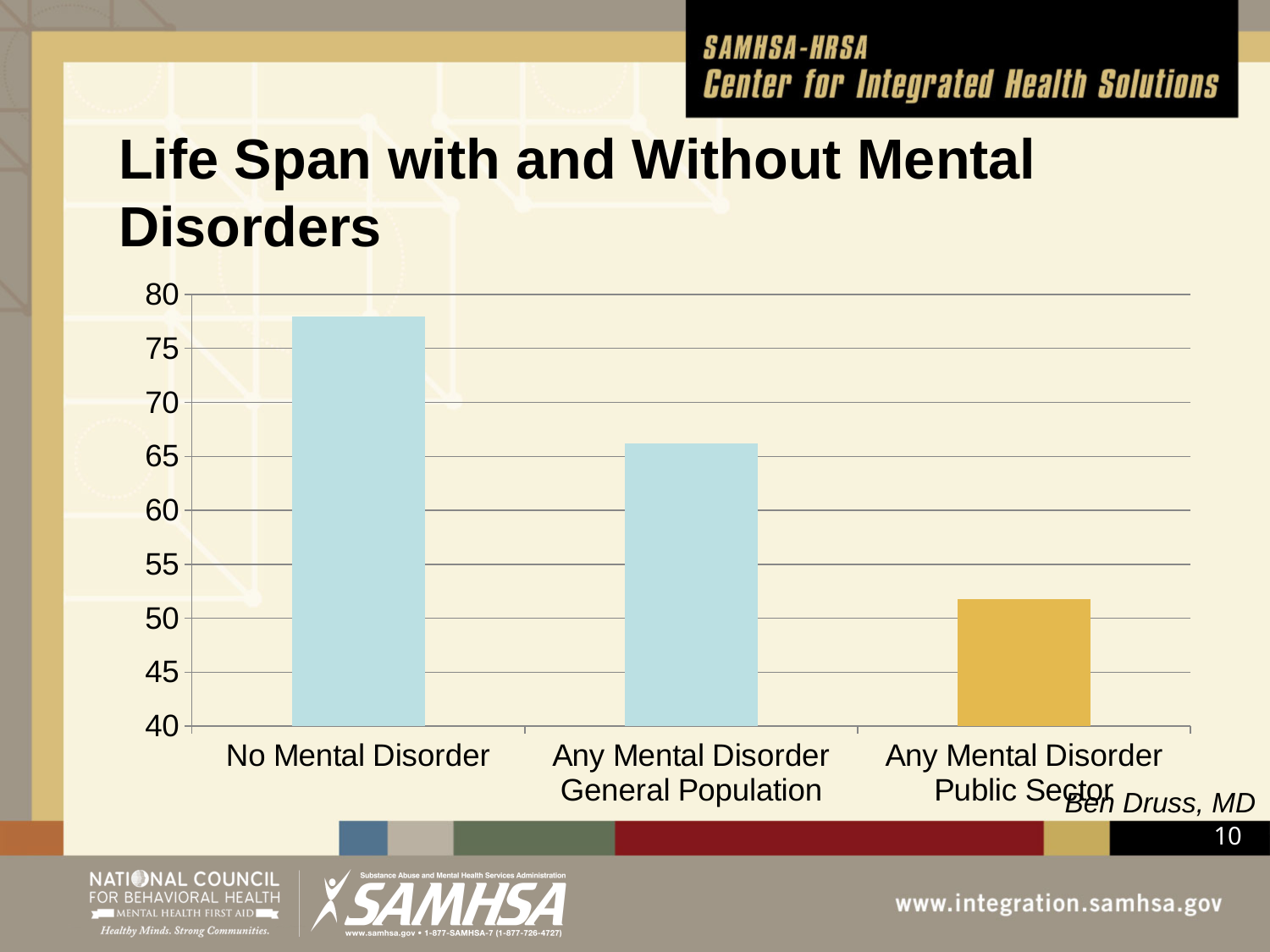
Which category has the lowest bar? Any Mental Disorder Public Sector Is the value for Any Mental Disorder General Population greater or less than 60? greater Do the bar values rise or fall from left to right across the categories? fall What kind of chart is shown on the slide? bar chart Which category's bar is coloured differently (gold) from the others? Any Mental Disorder Public Sector How many categories are plotted in the chart? 3 Is the value for Any Mental Disorder General Population greater or less than 70? less What is the title of the chart? Life Span with and Without Mental Disorders Which is larger, the value for Any Mental Disorder General Population or the value for Any Mental Disorder Public Sector? Any Mental Disorder General Population Is the value for Any Mental Disorder Public Sector greater or less than 55? less Which category has the highest bar? No Mental Disorder